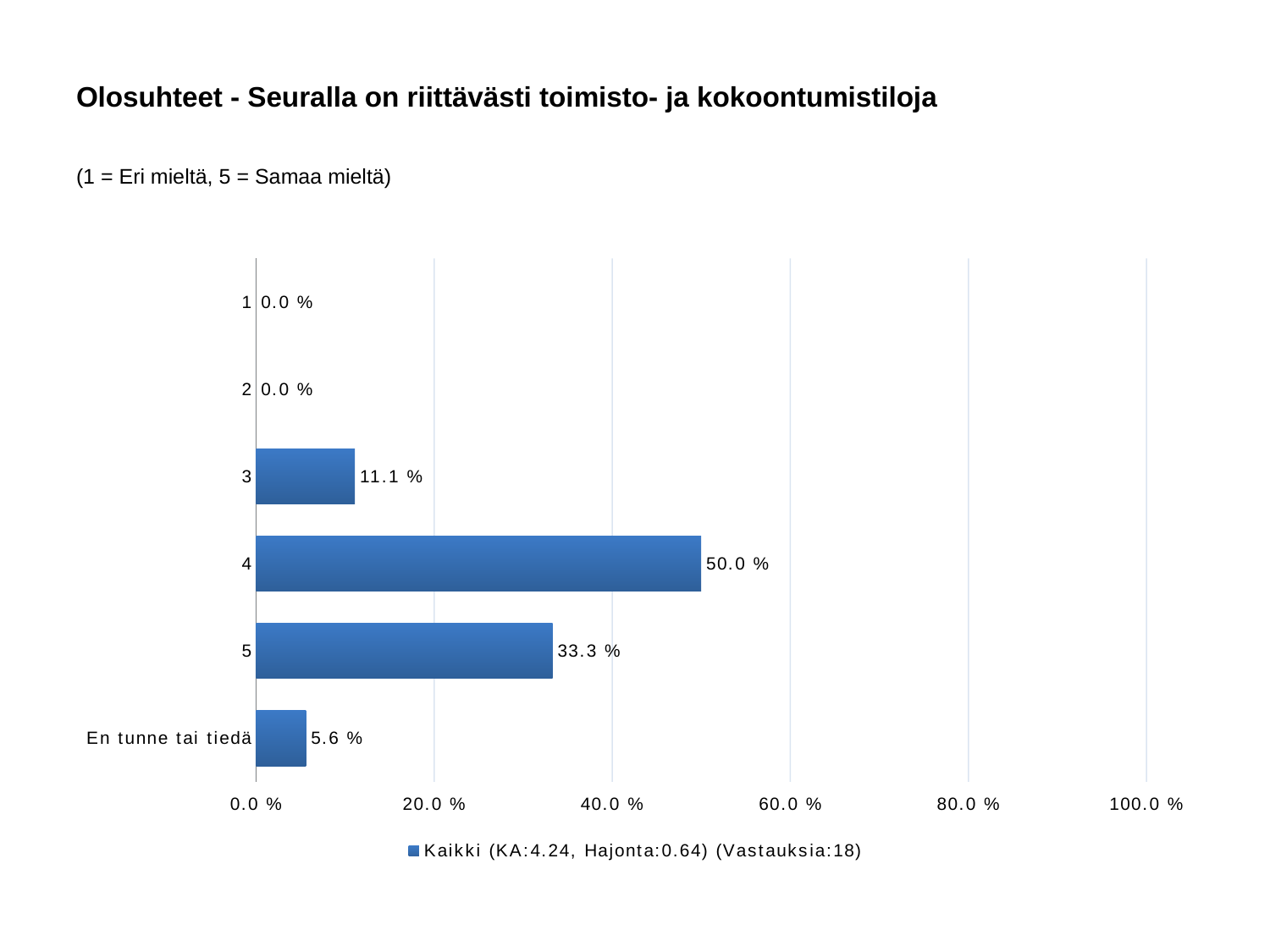
What is the value for category 4? 50.0 % What is the legend entry of the series shown? Kaikki (KA:4.24, Hajonta:0.64) (Vastauksia:18) What is the difference between the values for category 4 and category 5? 16.7 % What is the value for "En tunne tai tiedä"? 5.6 % What is the value for category 3? 11.1 % Is the value for category 5 greater or less than 40.0 %? less How many series does the legend list? 1 Which is larger, the value for category 3 or the value for "En tunne tai tiedä"? 3 How many categories are shown on the chart? 6 What kind of chart is shown on the slide? bar chart What is the value for category 5? 33.3 % Which category has the highest value? 4